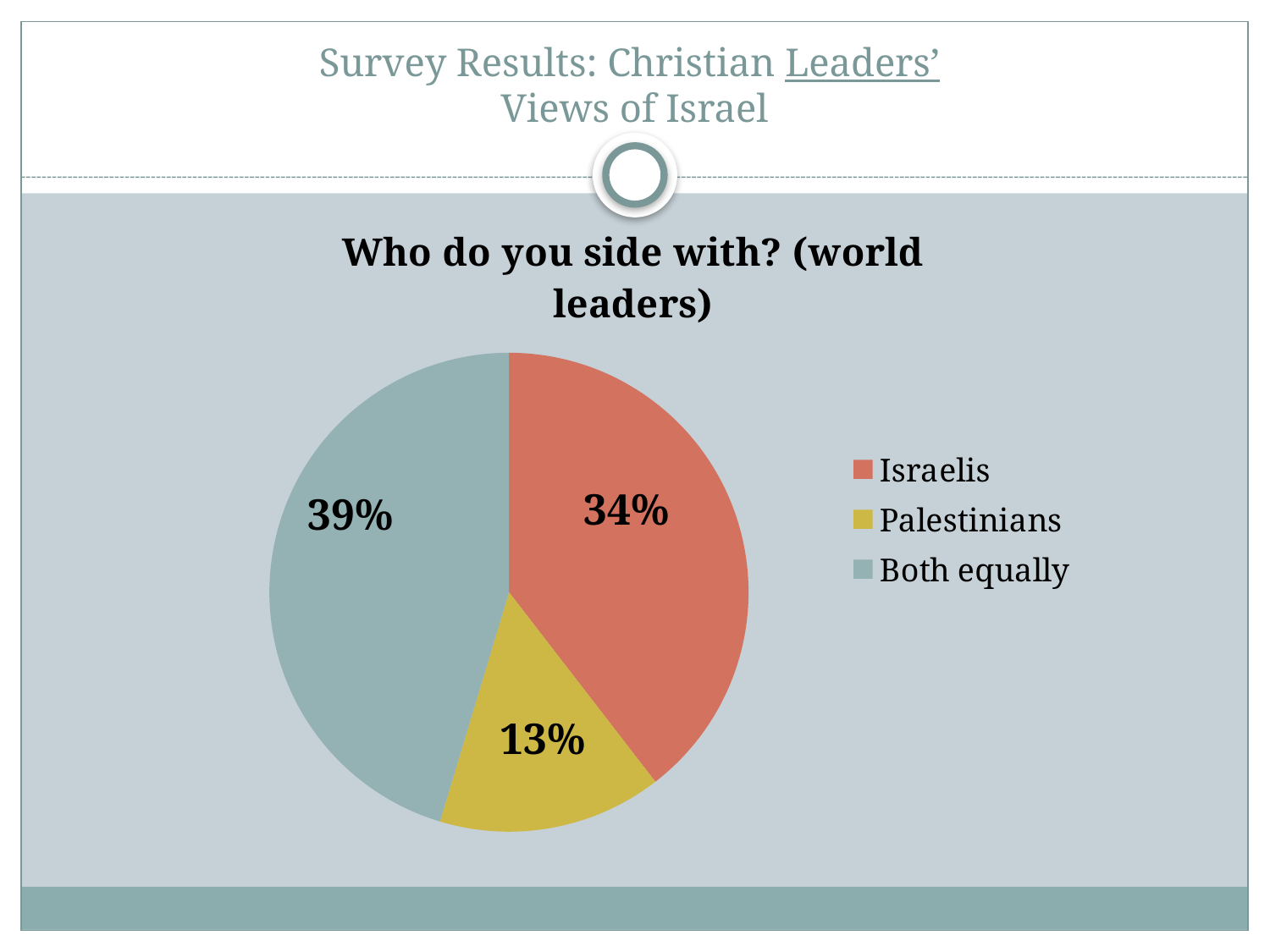
How many slices does the pie chart have? 3 What percentage of respondents side with the Palestinians? 13% Which category has the smallest share of the pie? Palestinians What colour is the Palestinians slice? yellow How many entries does the legend list? 3 What percentage of respondents side with both equally? 39% What percentage of respondents side with the Israelis? 34% What is the chart's title? Who do you side with? (world leaders) Which is larger, the share for Israelis or the share for Palestinians? Israelis What kind of chart is shown on the slide? pie chart What is the difference in percentage points between the Both equally slice and the Israelis slice? 5 Which category has the largest share of the pie? Both equally